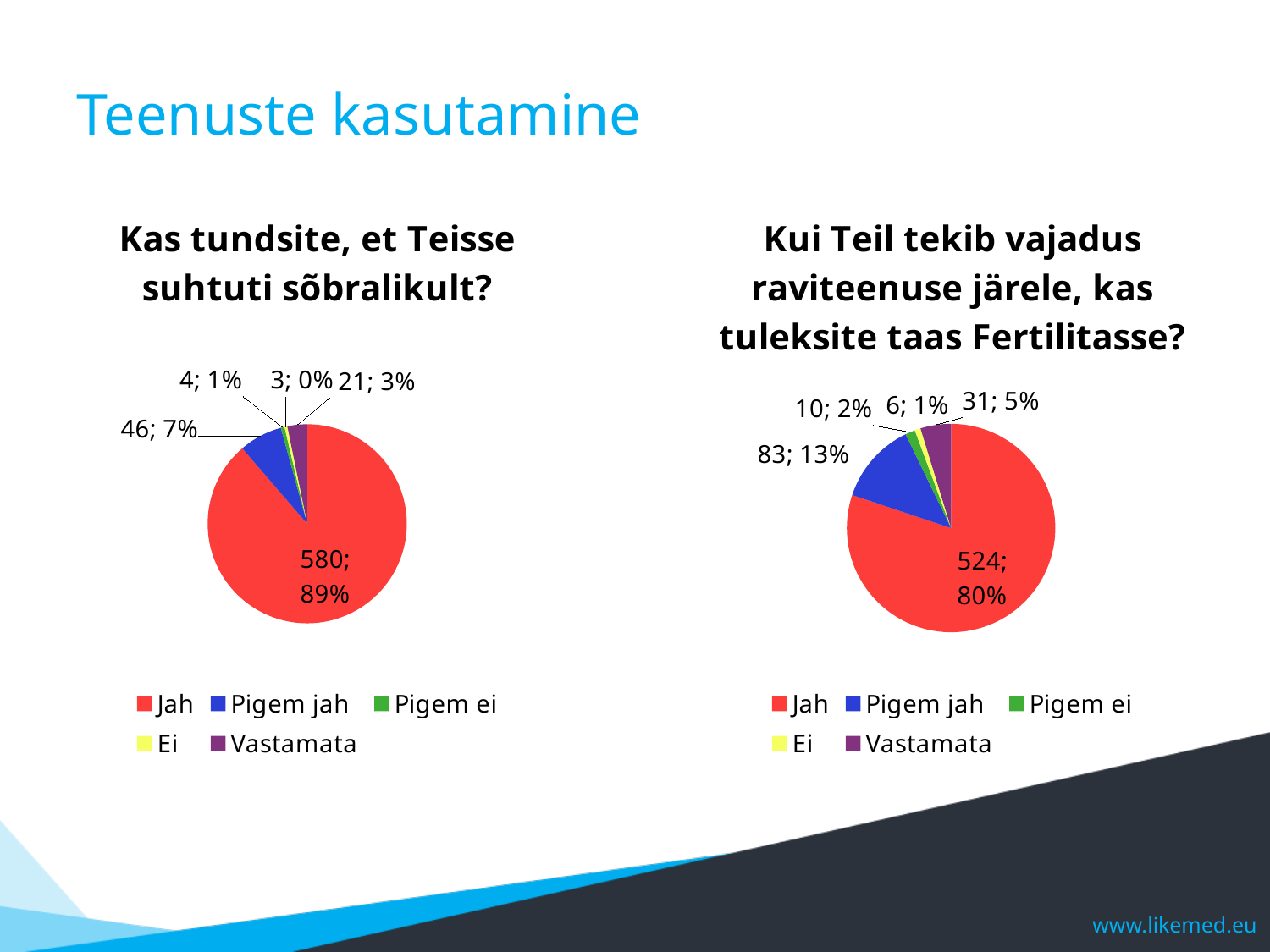
On the right chart (Kui Teil tekib vajadus raviteenuse järele, kas tuleksite taas Fertilitasse?), what value and share are shown for Jah? 524; 80% How many categories does the legend of the right chart list? 5 What type of chart is used on the left side of the slide? Pie chart On the right chart (Kui Teil tekib vajadus raviteenuse järele, kas tuleksite taas Fertilitasse?), what is the difference between the Jah count and the Pigem jah count? 441 On the left chart (Kas tundsite, et Teisse suhtuti sõbralikult?), what value and share are shown for Jah? 580; 89% On the right chart (Kui Teil tekib vajadus raviteenuse järele, kas tuleksite taas Fertilitasse?), what value and share are shown for Vastamata? 31; 5% On the left chart (Kas tundsite, et Teisse suhtuti sõbralikult?), what value and share are shown for Vastamata? 21; 3% On the right chart (Kui Teil tekib vajadus raviteenuse järele, kas tuleksite taas Fertilitasse?), what value and share are shown for Pigem jah? 83; 13% On the left chart (Kas tundsite, et Teisse suhtuti sõbralikult?), what value and share are shown for Pigem jah? 46; 7% On the left chart (Kas tundsite, et Teisse suhtuti sõbralikult?), which category has the largest slice? Jah On the right chart (Kui Teil tekib vajadus raviteenuse järele, kas tuleksite taas Fertilitasse?), which category has the largest slice? Jah Which chart has the larger count for Jah, the left chart or the right chart? The left chart